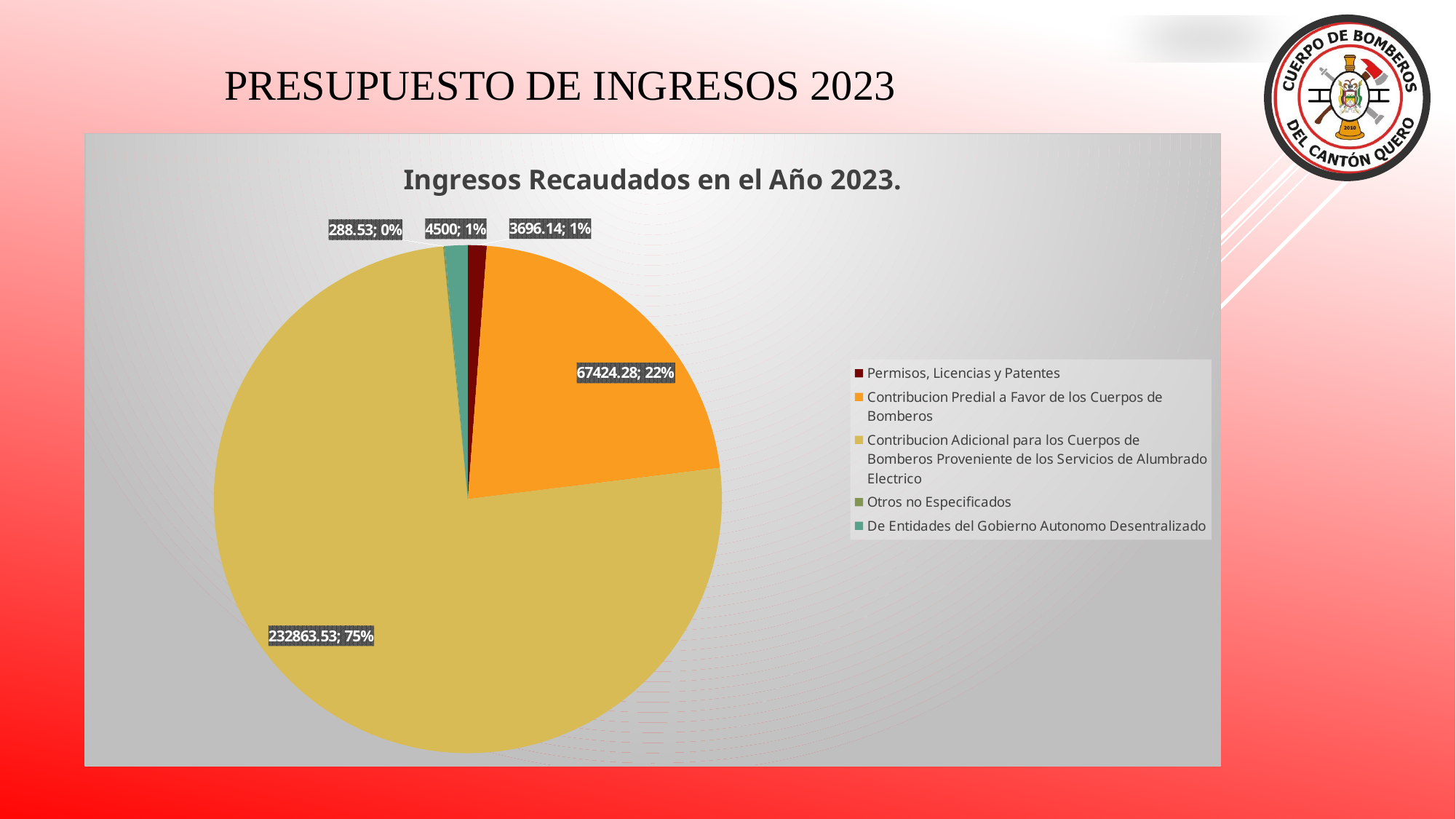
What value is shown for De Entidades del Gobierno Autonomo Desentralizado? 4500 What share of the pie does Contribucion Predial a Favor de los Cuerpos de Bomberos represent? 22% What type of chart is shown on the slide? pie chart What value is shown for Contribucion Predial a Favor de los Cuerpos de Bomberos? 67424.28 Which category has the smallest slice of the pie? Otros no Especificados Which is larger, the value for Contribucion Predial a Favor de los Cuerpos de Bomberos or the value for Permisos, Licencias y Patentes? Contribucion Predial a Favor de los Cuerpos de Bomberos What value is shown for Permisos, Licencias y Patentes? 3696.14 What share of the pie does Contribucion Adicional para los Cuerpos de Bomberos Proveniente de los Servicios de Alumbrado Electrico represent? 75% What is the title of the chart? Ingresos Recaudados en el Año 2023. How many categories does the legend of the pie chart list? 5 Which category has the largest slice of the pie? Contribucion Adicional para los Cuerpos de Bomberos Proveniente de los Servicios de Alumbrado Electrico What value is shown for Contribucion Adicional para los Cuerpos de Bomberos Proveniente de los Servicios de Alumbrado Electrico? 232863.53